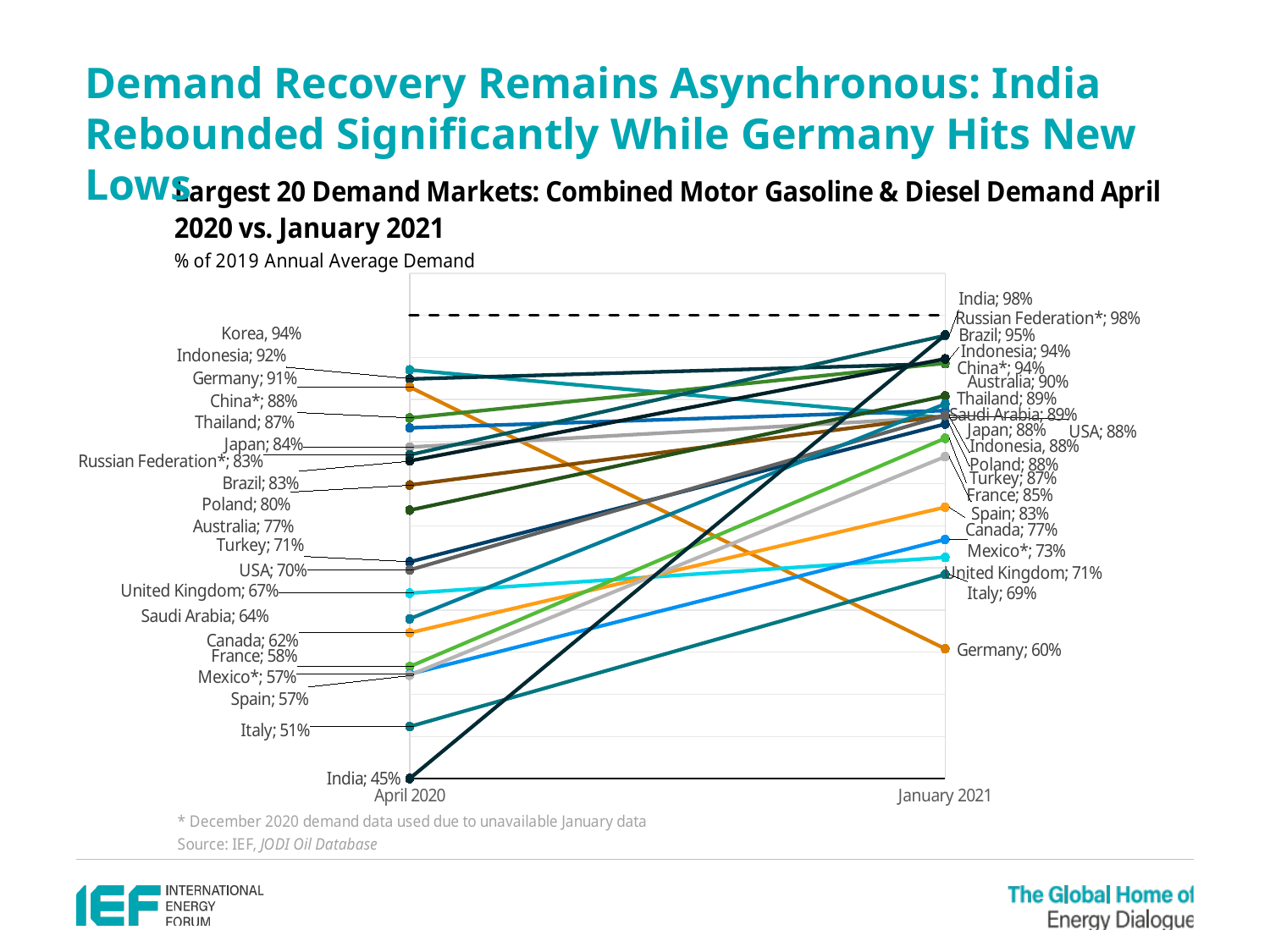
In April 2020, which was higher: Spain or Italy? Spain Which country had the lowest value in January 2021? Germany What was Brazil's value in January 2021? 95% Does Germany's value rise or fall from April 2020 to January 2021? Fall By how many percentage points did India's value change from April 2020 to January 2021? 53 percentage points What was India's value in April 2020? 45% Which country had the highest value in April 2020? Korea What kind of chart is shown on the slide? Line chart How many time points are shown on the x axis? 2 What was Germany's value in January 2021? 60% By how many percentage points did Germany's value fall from April 2020 to January 2021? 31 percentage points Which country had the lowest value in April 2020? India